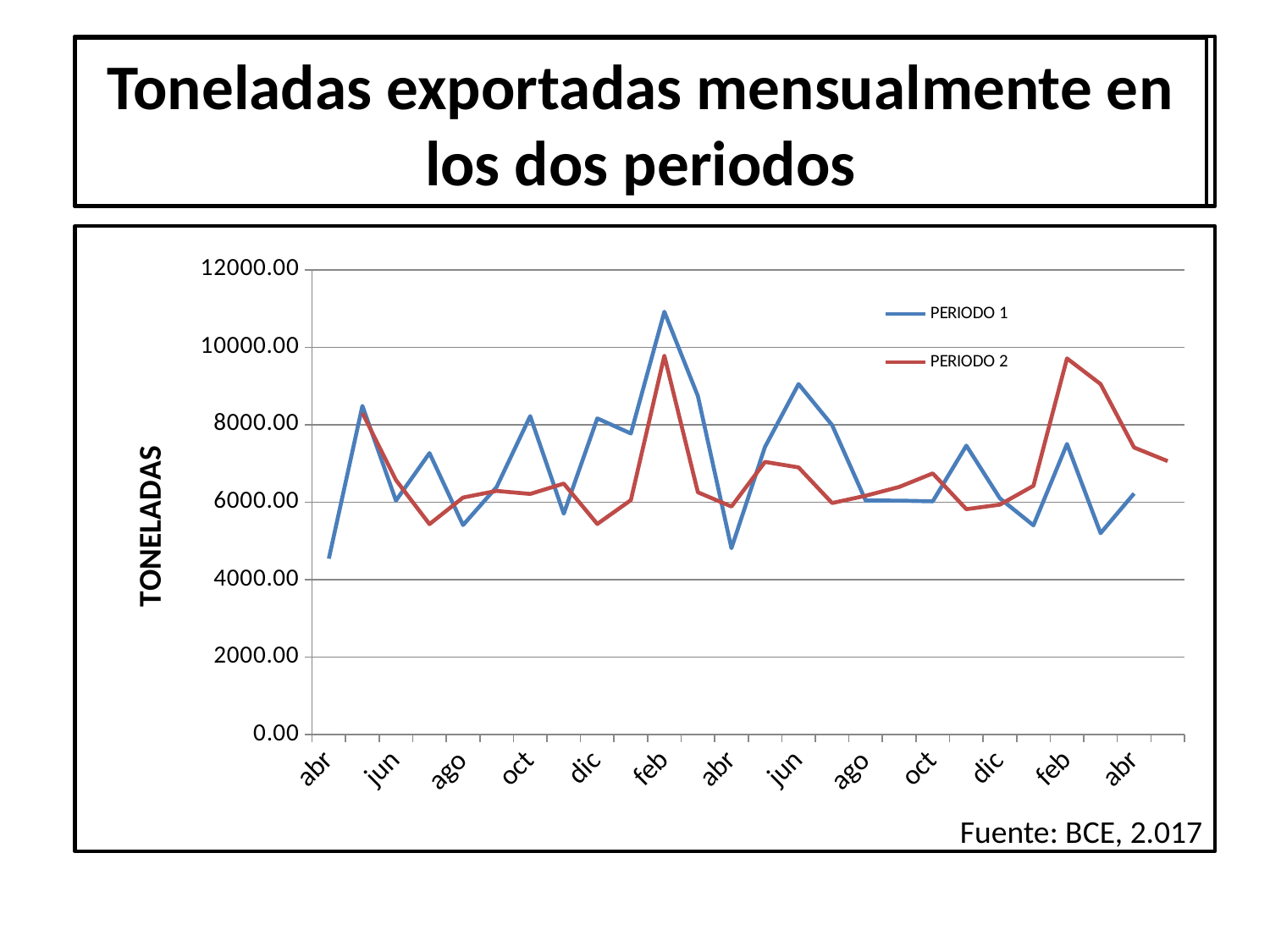
How many series does the legend list? 2 Is the value for PERIODO 1 at the first abr greater or less than 6000.00? less What are the names of the two series in the legend? PERIODO 1 and PERIODO 2 At the second feb, which series has the larger value, PERIODO 1 or PERIODO 2? PERIODO 2 At the first feb, which series has the larger value, PERIODO 1 or PERIODO 2? PERIODO 1 How many month labels are shown along the x axis? 13 At which x-axis label does PERIODO 1 reach its highest value? feb (the first feb) At the second jun, which series has the larger value, PERIODO 1 or PERIODO 2? PERIODO 1 What is the title of the vertical axis? TONELADAS Is the value for PERIODO 1 at the first feb greater or less than 10000.00? greater What kind of chart is shown on the slide? line chart Is the value for PERIODO 2 at the second feb greater or less than 8000.00? greater